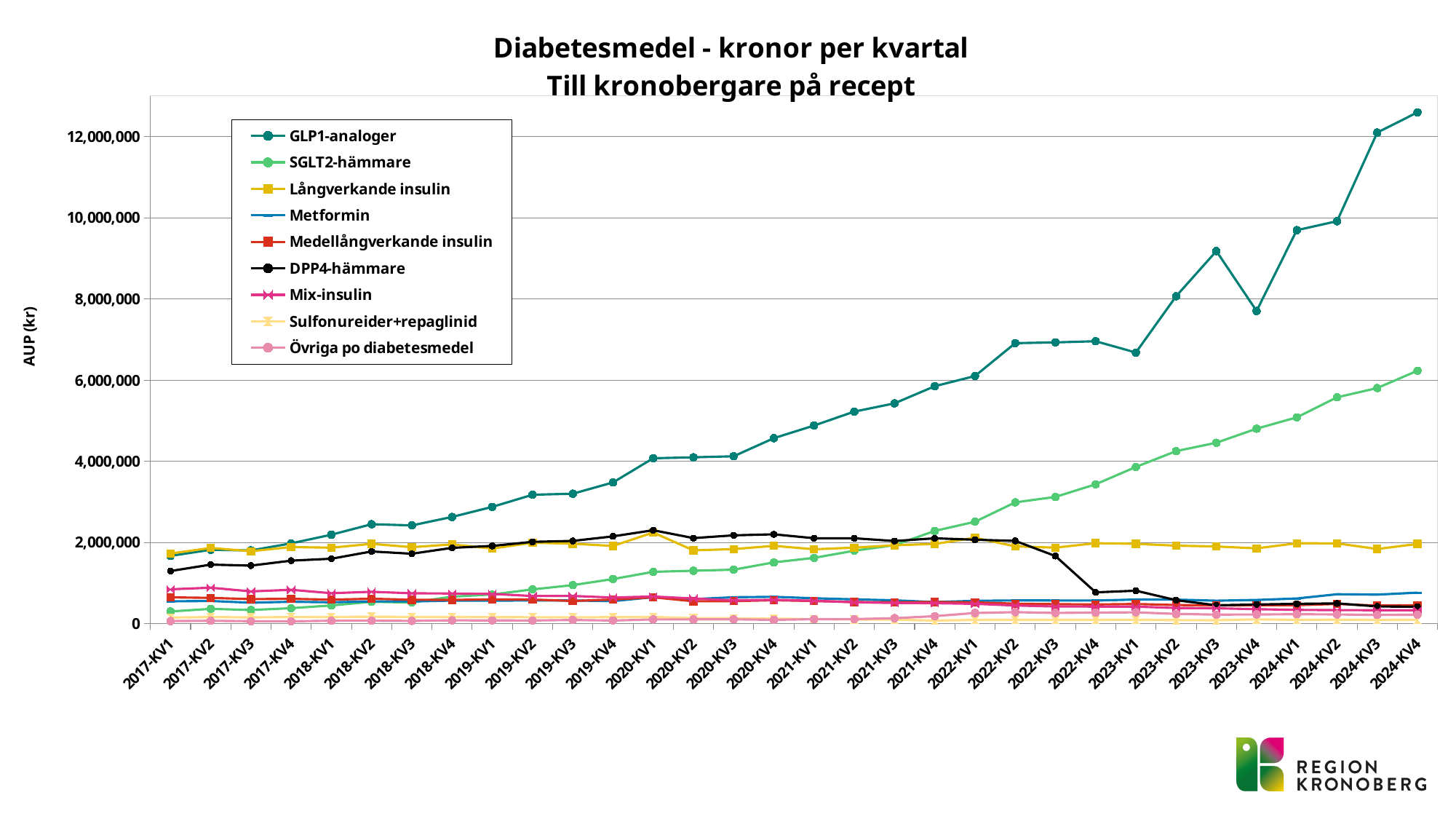
What kind of chart is shown on the slide? line chart Which series has the highest value at 2024-KV4? GLP1-analoger Does the GLP1-analoger series generally rise or fall from 2017-KV1 to 2024-KV4? rise Is the value for GLP1-analoger at 2024-KV4 greater or less than 12,000,000? greater How many series does the legend list? 9 Is the value for GLP1-analoger at 2022-KV2 greater or less than 8,000,000? less How many quarters are plotted along the x axis? 32 Does the DPP4-hämmare series rise or fall between 2022-KV2 and 2023-KV1? fall Is the value for DPP4-hämmare at 2022-KV4 greater or less than 1,000,000? less At 2024-KV4, which is larger: SGLT2-hämmare or Långverkande insulin? SGLT2-hämmare What is the label on the y axis? AUP (kr)